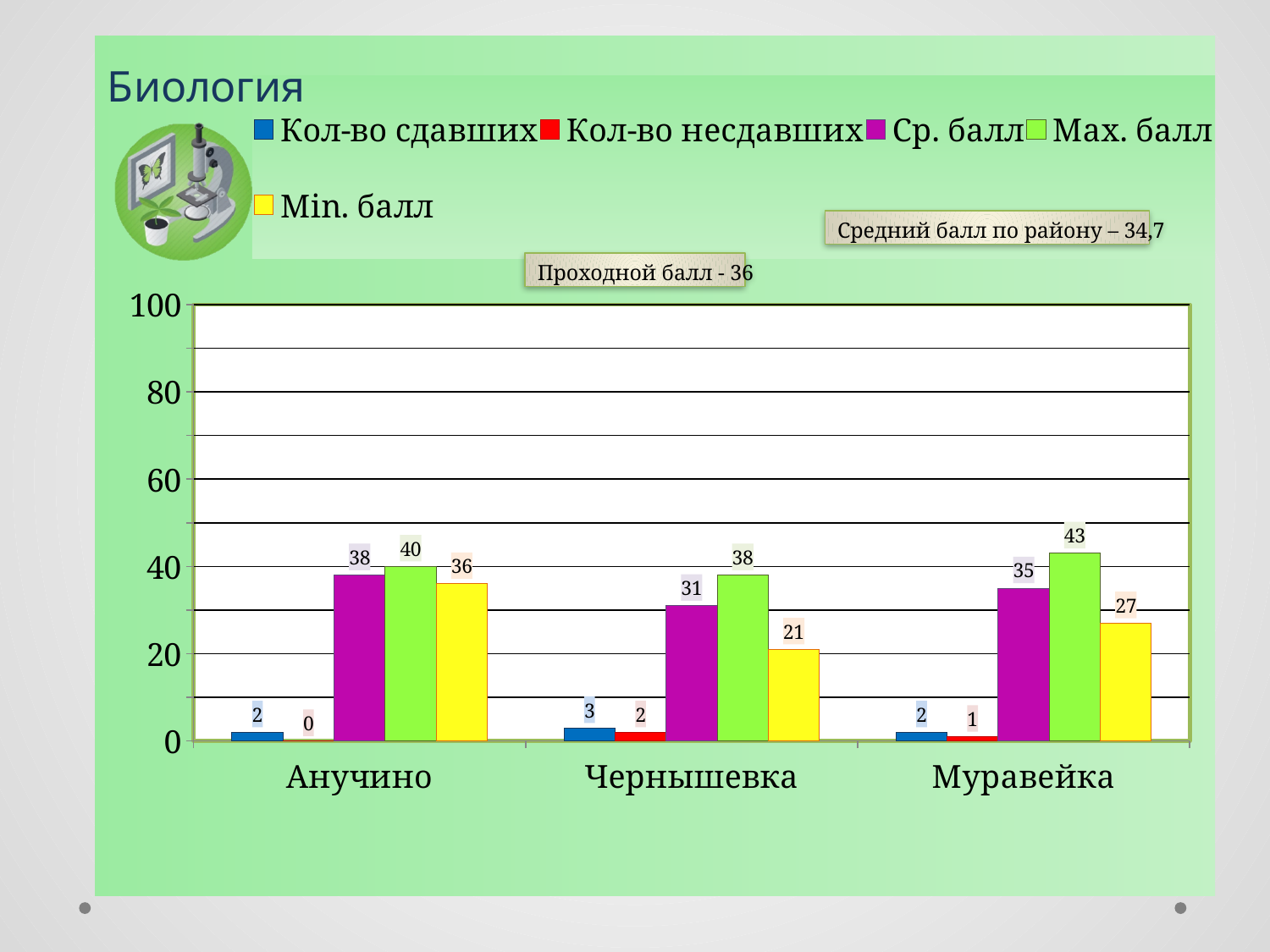
How many categories are shown on the x axis? 3 What colour represents the Max. балл series in the legend? green Which is larger: the Min. балл value for Анучино or the Min. балл value for Муравейка? Анучино Is the Ср. балл value for Чернышевка greater or less than 40? less What is the Ср. балл value for Анучино? 38 What is the Кол-во несдавших value for Муравейка? 1 What kind of chart is shown on the slide? bar chart Which category has the highest Max. балл value? Муравейка How many series does the legend list? 5 Which category has the lowest Ср. балл value? Чернышевка What is the Min. балл value for Чернышевка? 21 What is the difference between the Max. балл and Min. балл values for Муравейка? 16